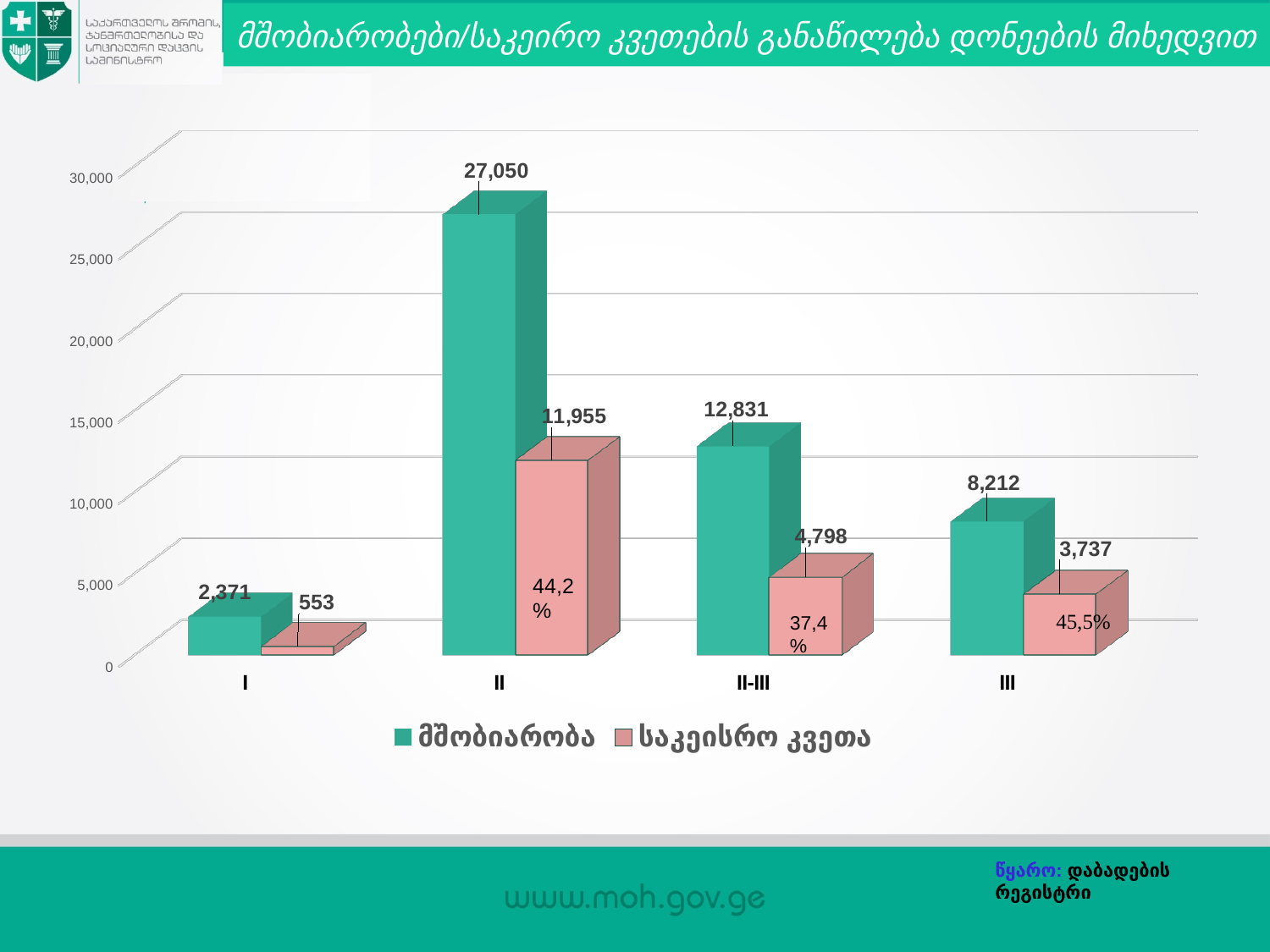
Which level has the highest value for მშობიარობა? II What is the difference between მშობიარობა and საკეისრო კვეთა at level III? 4,475 How many levels (categories) are shown on the x axis? 4 What percentage label is shown on the საკეისრო კვეთა bar at level III? 45,5% What kind of chart is shown on the slide? Bar chart What is the value for მშობიარობა at level II? 27,050 Which is larger: საკეისრო კვეთა at level II-III or საკეისრო კვეთა at level III? საკეისრო კვეთა at level II-III How many series does the legend list? 2 What is the value for საკეისრო კვეთა at level II-III? 4,798 What is the value for მშობიარობა at level III? 8,212 What is the value for საკეისრო კვეთა at level I? 553 Which level has the lowest value for საკეისრო კვეთა? I